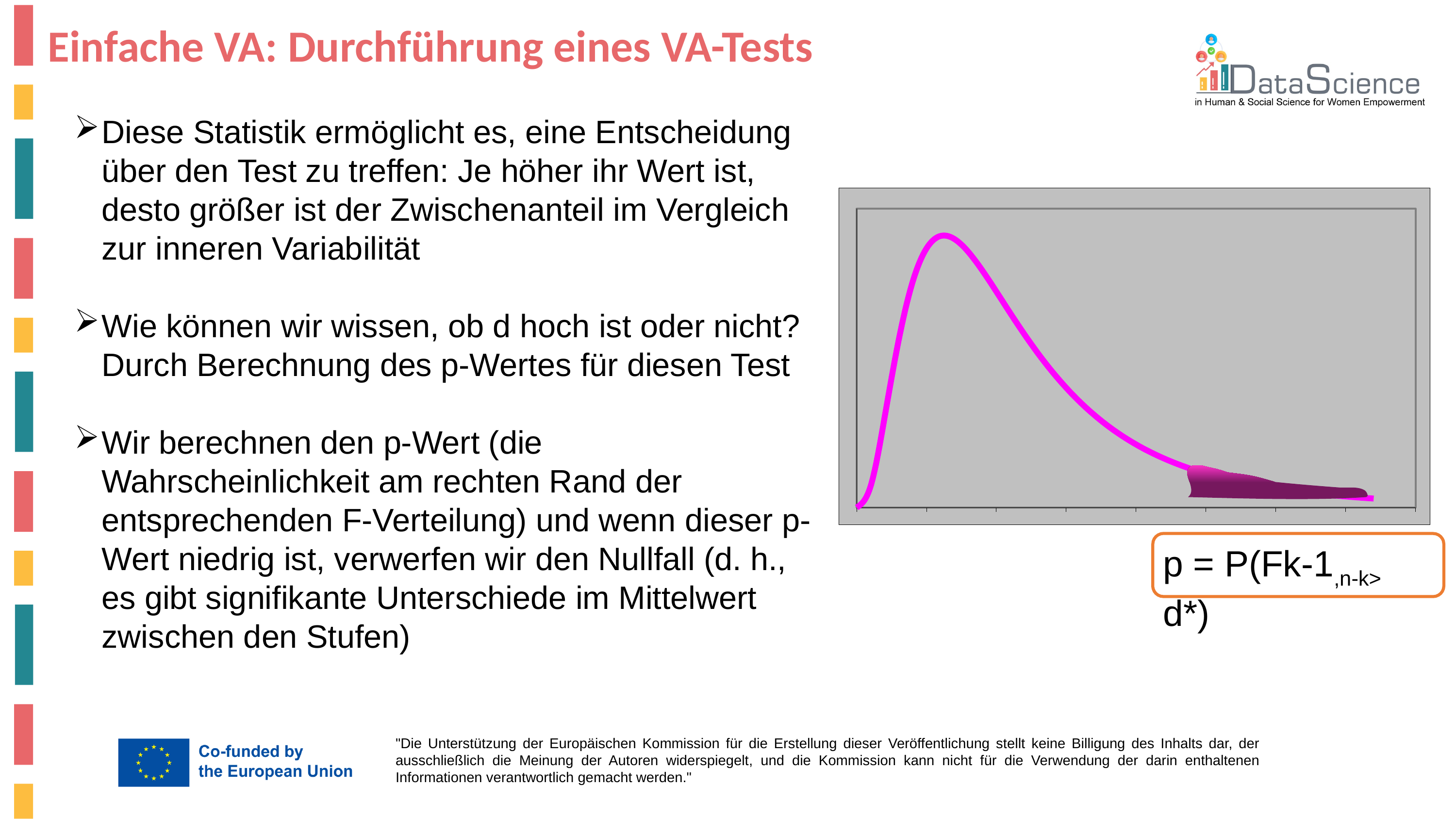
At which end of the curve is the shaded area under the curve located, left or right? Right Moving left to right along the x axis, does the curve rise or fall after reaching its peak? Fall Is the peak of the curve located in the left or the right half of the chart? Left What colour is the curve plotted in the chart? Magenta What kind of chart is shown on the right of the slide? Line chart